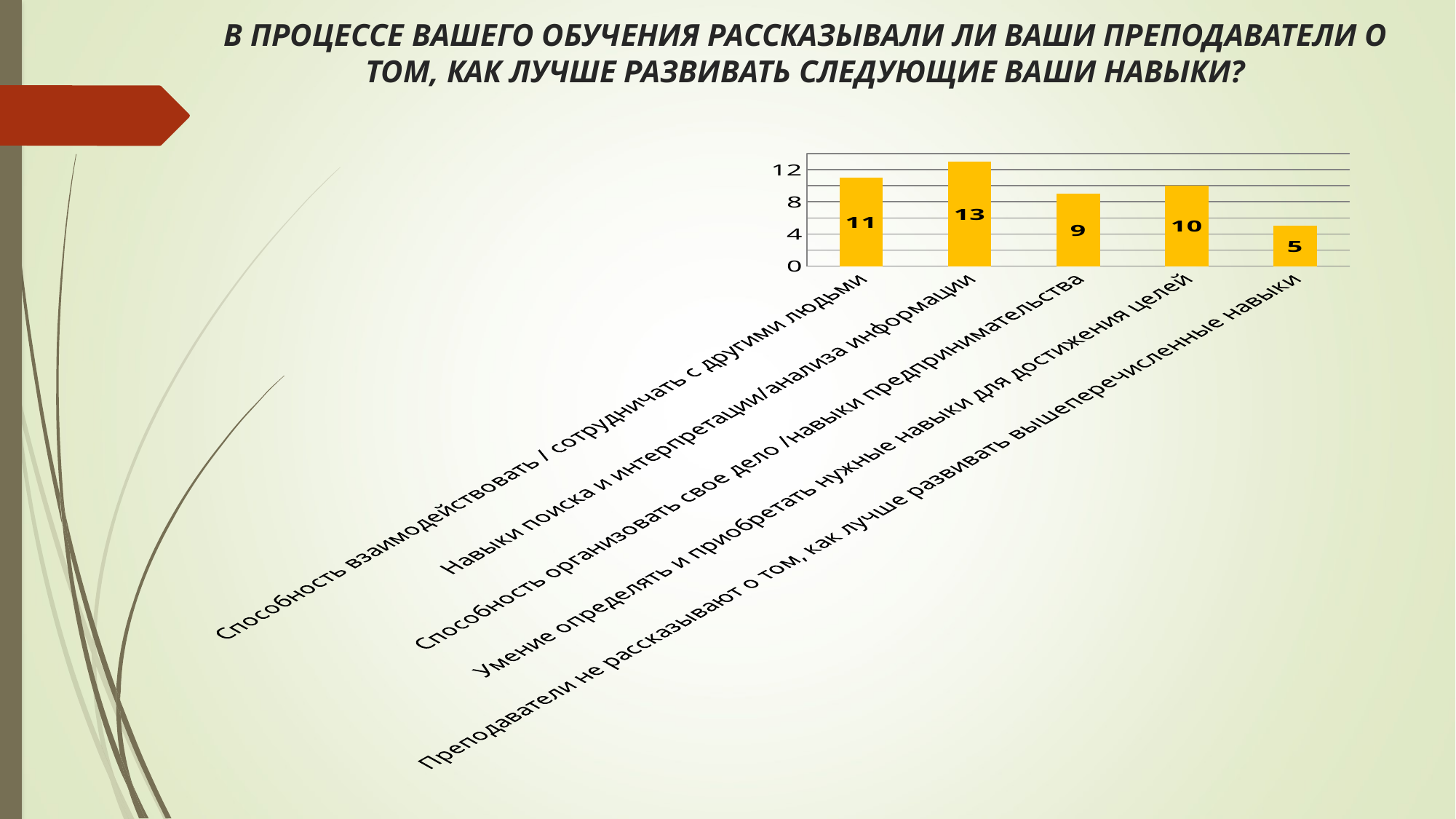
Which category has the highest value? Навыки поиска и интерпретации/анализа информации What colour are the bars in the chart? yellow What value is shown for "Преподаватели не рассказывают о том, как лучше развивать вышеперечисленные навыки"? 5 What value is shown for "Способность взаимодействовать / сотрудничать с другими людьми"? 11 How many categories are shown in the chart? 5 What kind of chart is shown on the slide? bar chart Which is larger: the value for "Способность взаимодействовать / сотрудничать с другими людьми" or the value for "Умение определять и приобретать нужные навыки для достижения целей"? Способность взаимодействовать / сотрудничать с другими людьми What value is shown for "Навыки поиска и интерпретации/анализа информации"? 13 What value is shown for "Умение определять и приобретать нужные навыки для достижения целей"? 10 Which category has the lowest value? Преподаватели не рассказывают о том, как лучше развивать вышеперечисленные навыки Is the value for "Способность организовать свое дело /навыки предпринимательства" greater or less than 12? less What is the difference between the values for "Навыки поиска и интерпретации/анализа информации" and "Способность организовать свое дело /навыки предпринимательства"? 4